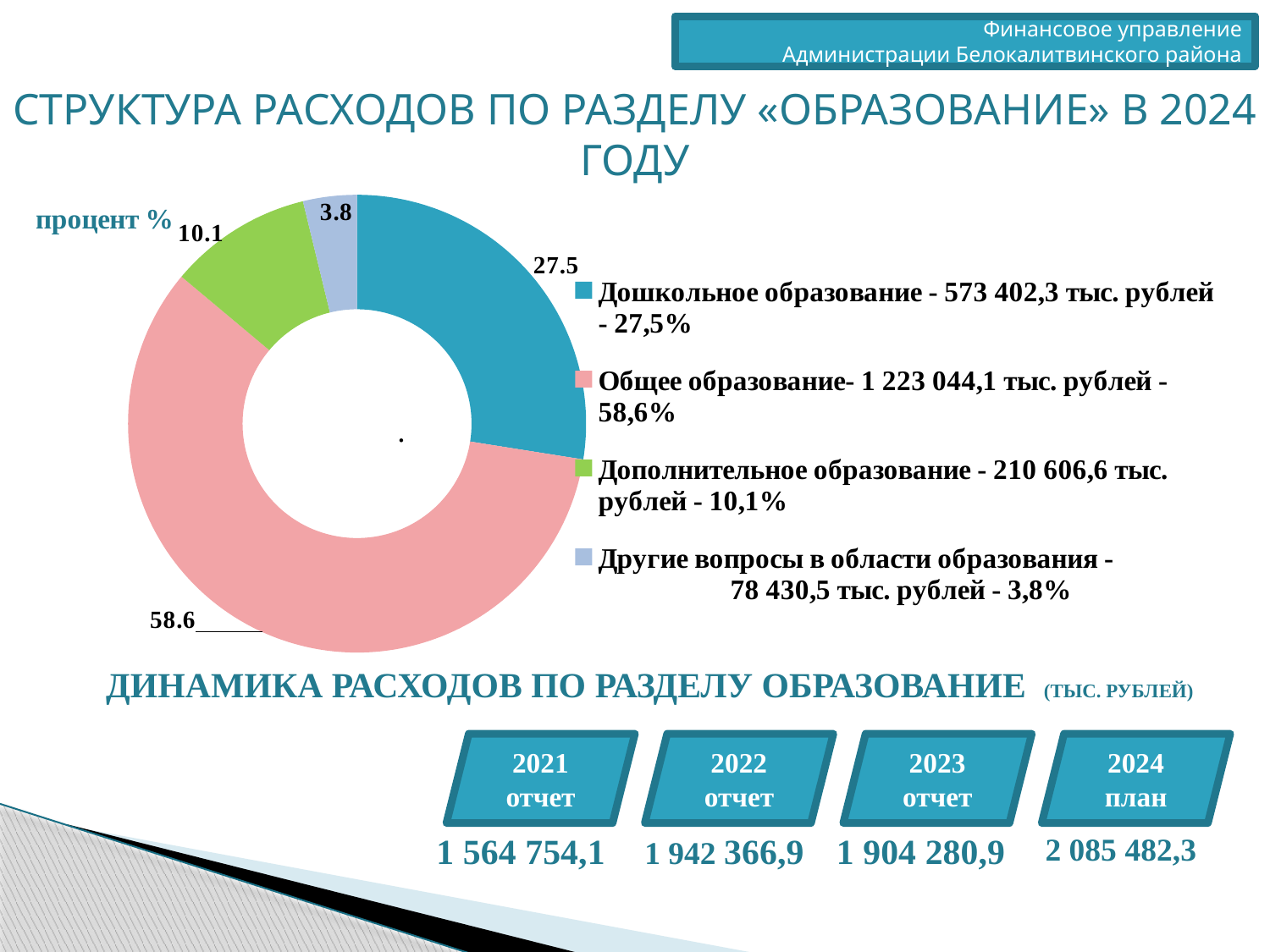
How many slices does the doughnut chart have? 4 What percentage is shown for Другие вопросы в области образования in the doughnut chart? 3.8 What is the difference in percentage points between Общее образование and Дошкольное образование in the doughnut chart? 31.1 What colour is the slice for Общее образование in the doughnut chart? pink How many entries does the legend of the doughnut chart list? 4 Which is larger in the doughnut chart: Дошкольное образование or Дополнительное образование? Дошкольное образование Which category has the largest share in the doughnut chart? Общее образование What percentage is shown for Дополнительное образование in the doughnut chart? 10.1 What percentage is shown for Дошкольное образование in the doughnut chart? 27.5 What percentage is shown for Общее образование in the doughnut chart? 58.6 Which category has the smallest share in the doughnut chart? Другие вопросы в области образования What kind of chart is shown on the slide? doughnut chart